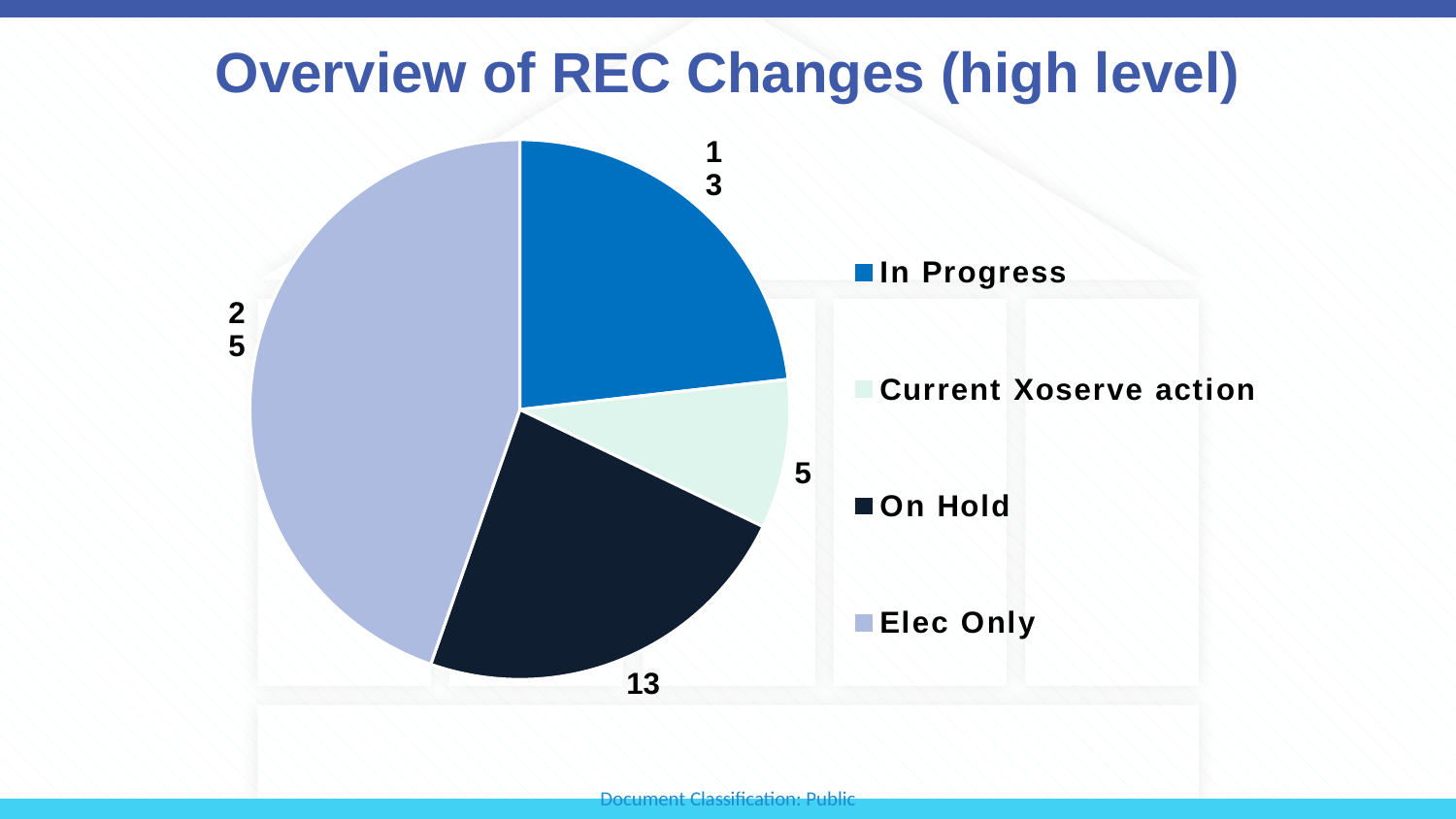
What is the title of the chart on the slide? Overview of REC Changes (high level) Which category has the smallest slice of the pie? Current Xoserve action How many slices does the pie chart have? 4 Which category has the largest slice of the pie? Elec Only What is the value for Elec Only? 25 What is the difference between the values for Elec Only and On Hold? 12 What is the value for Current Xoserve action? 5 What kind of chart is shown on the slide? pie chart How many entries does the legend list? 4 What is the value for On Hold? 13 What is the value for In Progress? 13 Which is larger, the value for In Progress or the value for Current Xoserve action? In Progress